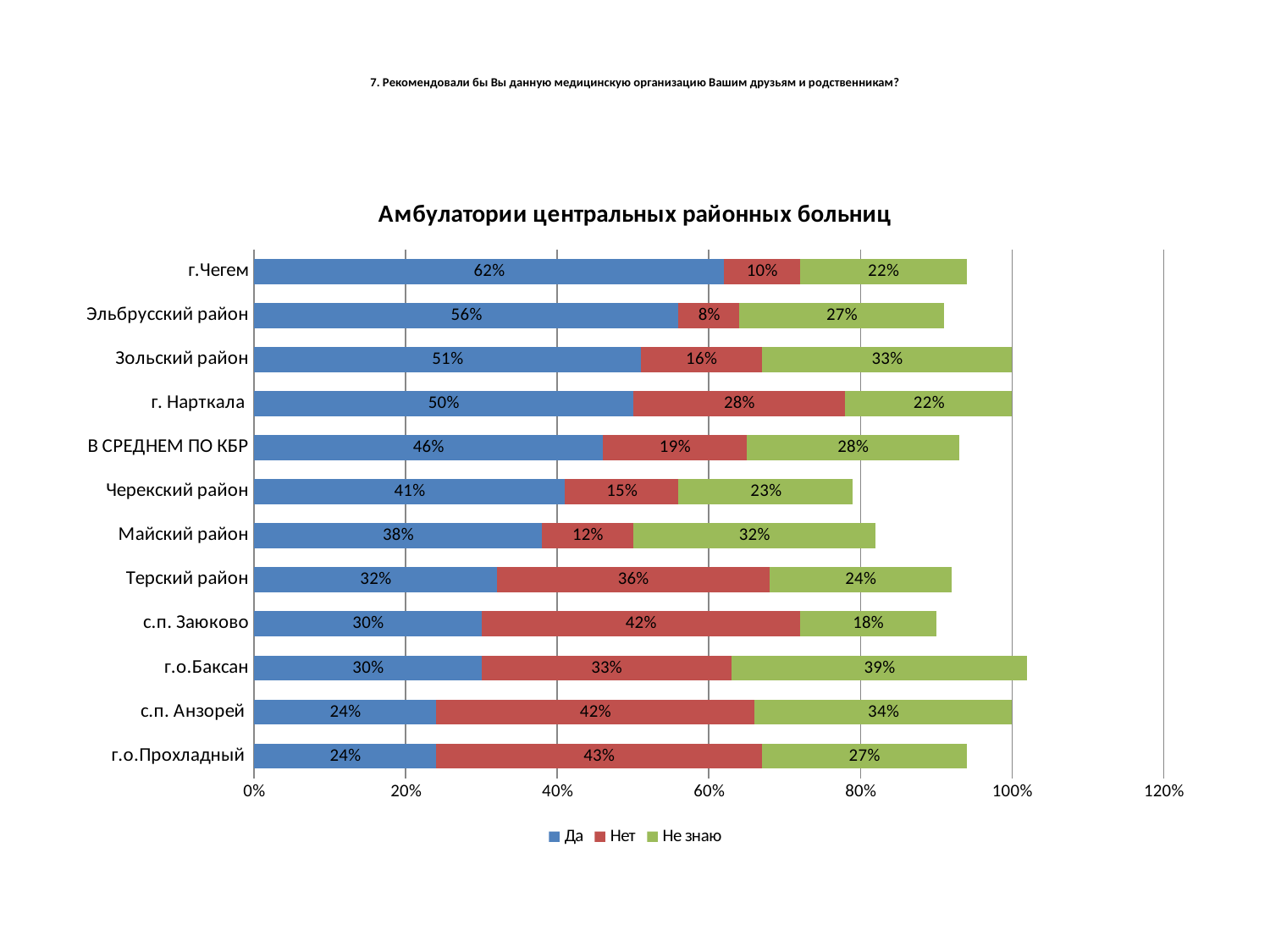
What is the difference between the "Да" and "Нет" values for г.Чегем? 52% How many categories are shown on the chart? 12 What is the total of the stacked bar for г.о.Баксан? 102% What is the value of the "Нет" series for г. Нарткала? 28% Which category has the highest value for the "Не знаю" series? г.о.Баксан What is the value of the "Не знаю" series for г.о.Баксан? 39% Which category has the highest value for the "Да" series? г.Чегем Which is larger: the "Нет" value for Терский район or the "Нет" value for Майский район? Терский район How many series does the legend list? 3 What is the value of the "Да" series for г.Чегем? 62% Which category has the lowest value for the "Нет" series? Эльбрусский район What kind of chart is shown on the slide? Stacked bar chart